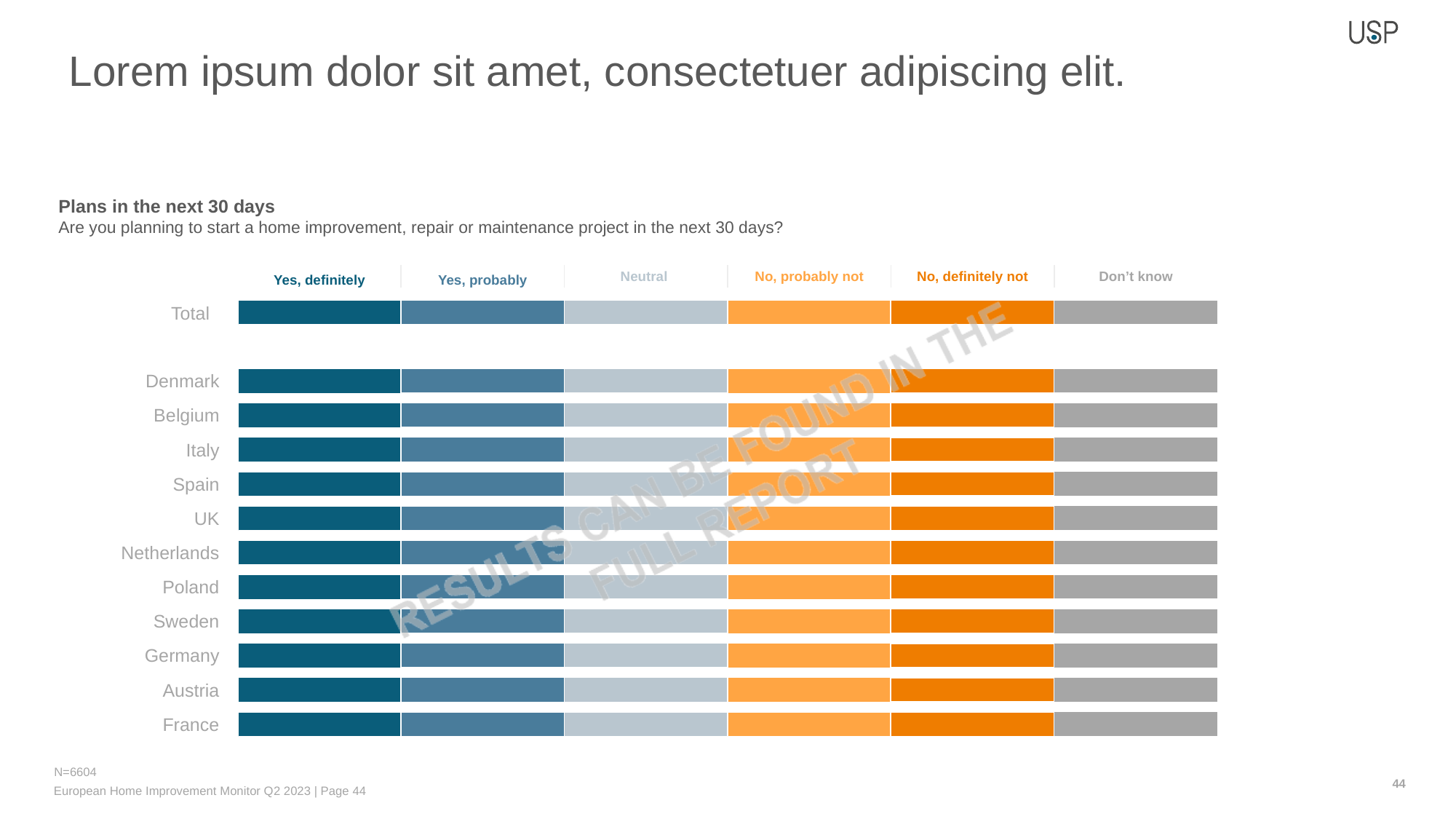
How many countries are listed as rows in the chart, excluding the Total row? 11 Which country is listed in the last row of the chart? France Which legend entry is shown in the darkest orange colour? No, definitely not What is the sample size (N) stated below the chart? N=6604 What kind of chart is shown on the slide? Stacked bar chart How many response categories (series) does the chart's legend list? 6 Which country is listed in the first row below Total? Denmark What is the title of the chart? Plans in the next 30 days